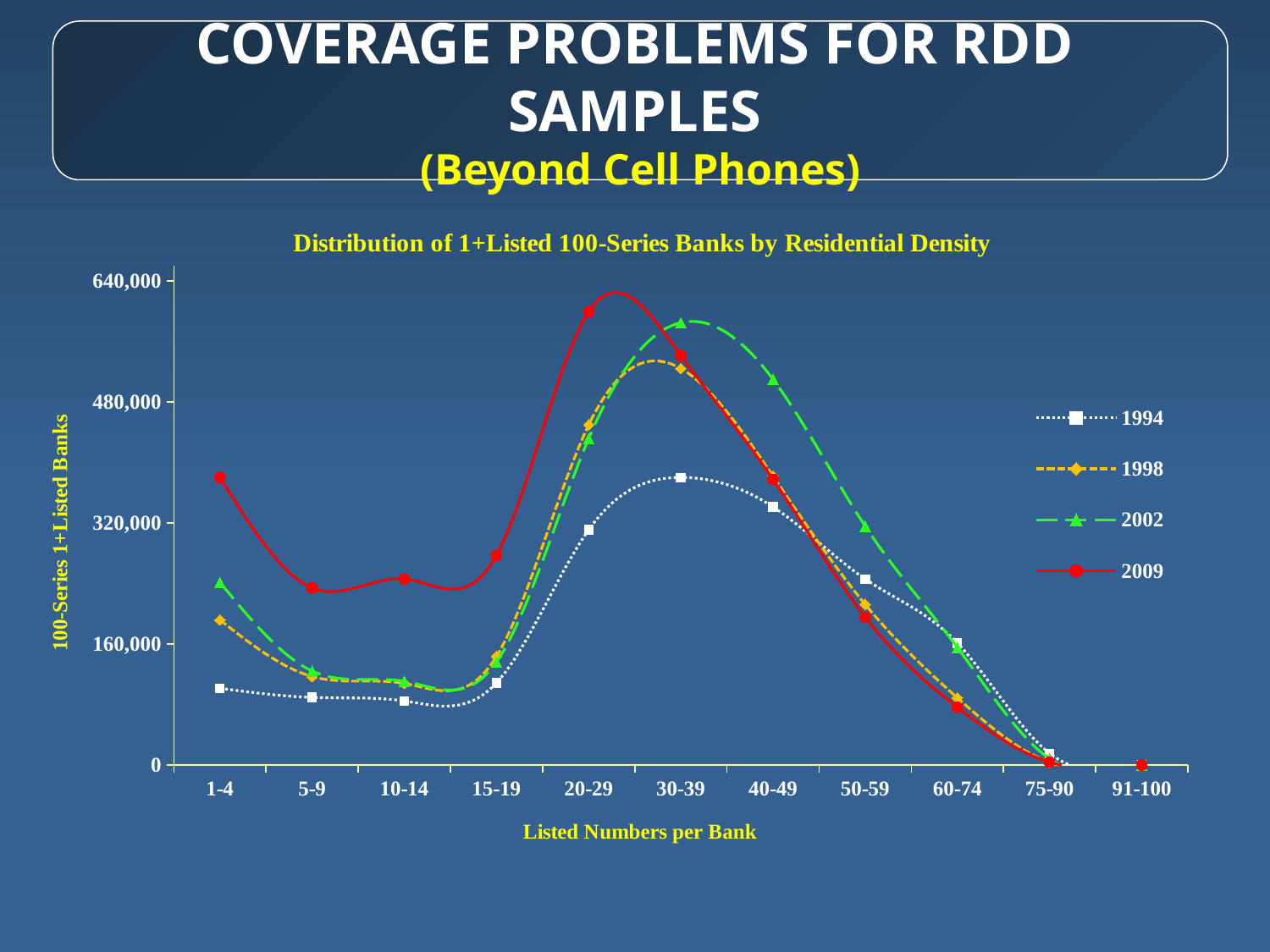
Is the value for the 1994 series at 1-4 greater or less than 160,000? less Do the values for the 2009 series rise or fall from 30-39 to 91-100? fall Which series has the highest value at the 20-29 category? 2009 How many series does the legend list? 4 Is the value for the 2009 series at 1-4 greater or less than 320,000? greater What kind of chart is shown on the slide? line chart For the 2009 series, which category has the highest value? 20-29 For the 2002 series, which category has the highest value? 30-39 What is the title of the chart? Distribution of 1+Listed 100-Series Banks by Residential Density Is the value for the 2009 series at 20-29 greater or less than 480,000? greater At the 40-49 category, which series has the larger value, 2002 or 2009? 2002 How many categories are shown on the x axis? 11